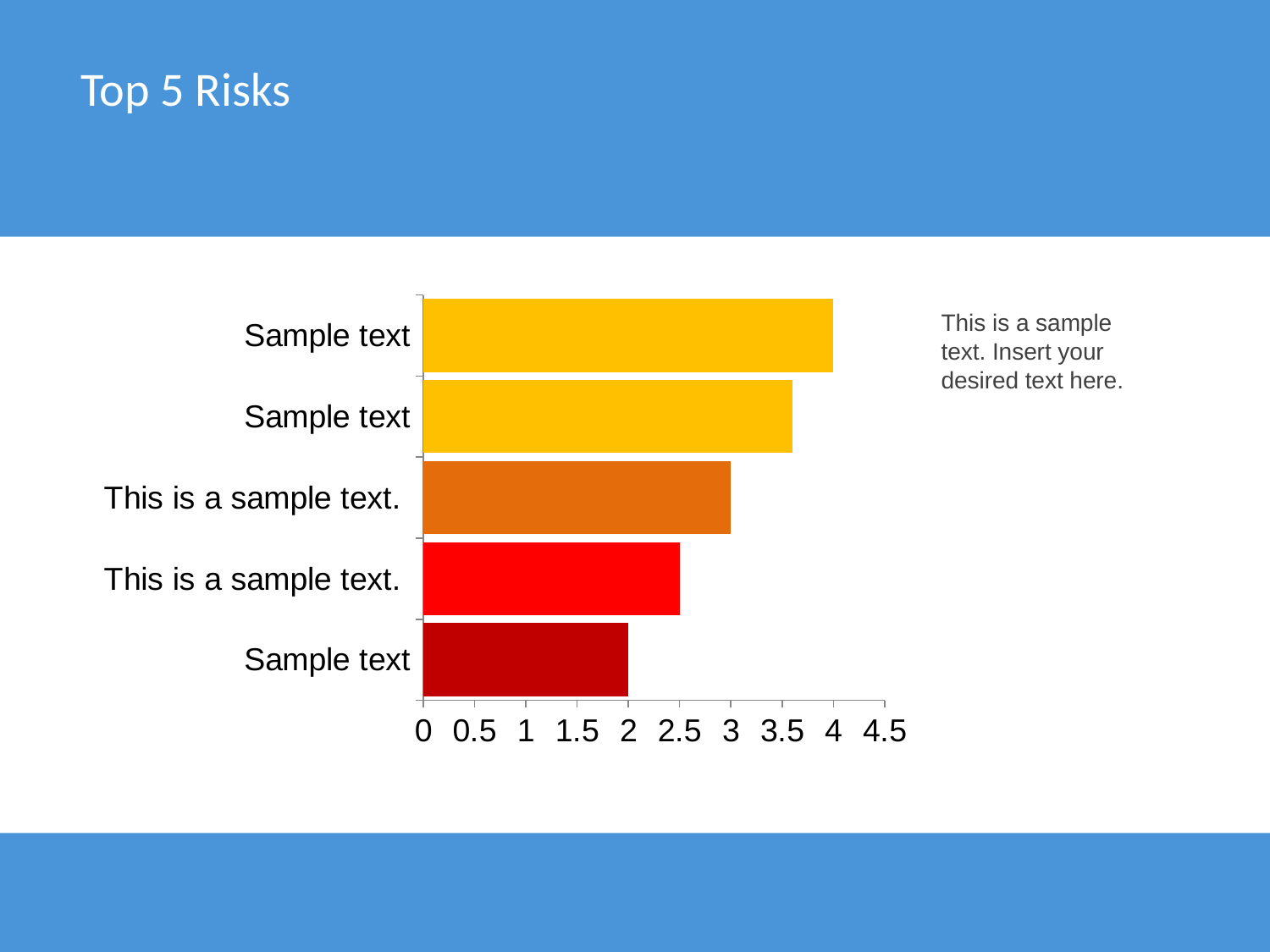
Is the value of the second bar from the top greater or less than 3.5? greater What is the value of the middle (third from top) bar in the chart? 3 Which bar has the highest value? the top bar What is the title of the slide containing the chart? Top 5 Risks What is the value of the top bar in the chart? 4 What is the value of the fourth bar from the top (the red bar)? 2.5 What kind of chart is shown on the slide? bar chart Do the bar values increase or decrease going from the top bar to the bottom bar? decrease Which bar has the lowest value? the bottom bar What is the value of the bottom bar in the chart? 2 How many bars are plotted in the chart? 5 What is the difference between the value of the top bar and the value of the bottom bar? 2